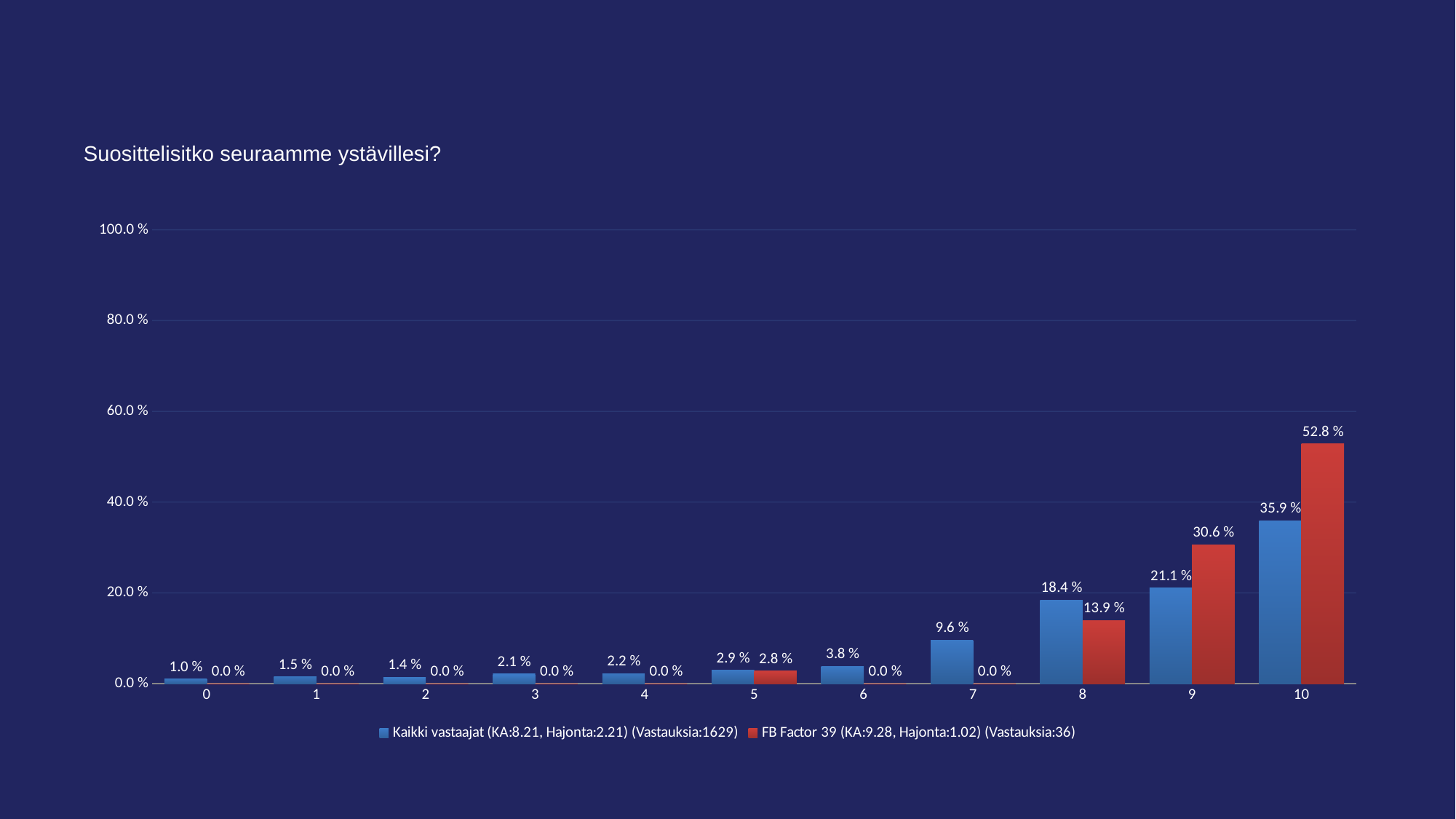
What is the value for category 7 in the Kaikki vastaajat series? 9.6 % Which category has the lowest value in the Kaikki vastaajat series? 0 How many categories are shown on the x axis? 11 What is the value for category 8 in the FB Factor 39 series? 13.9 % What is the difference between the FB Factor 39 and Kaikki vastaajat values for category 10? 16.9 % What kind of chart is shown on the slide? Bar chart Which category has the highest value in the FB Factor 39 series? 10 What is the title of the chart? Suosittelisitko seuraamme ystävillesi? How many series does the legend list? 2 For category 8, which series has the larger value, Kaikki vastaajat or FB Factor 39? Kaikki vastaajat What is the value for category 10 in the FB Factor 39 series? 52.8 % What is the value for category 10 in the Kaikki vastaajat series? 35.9 %